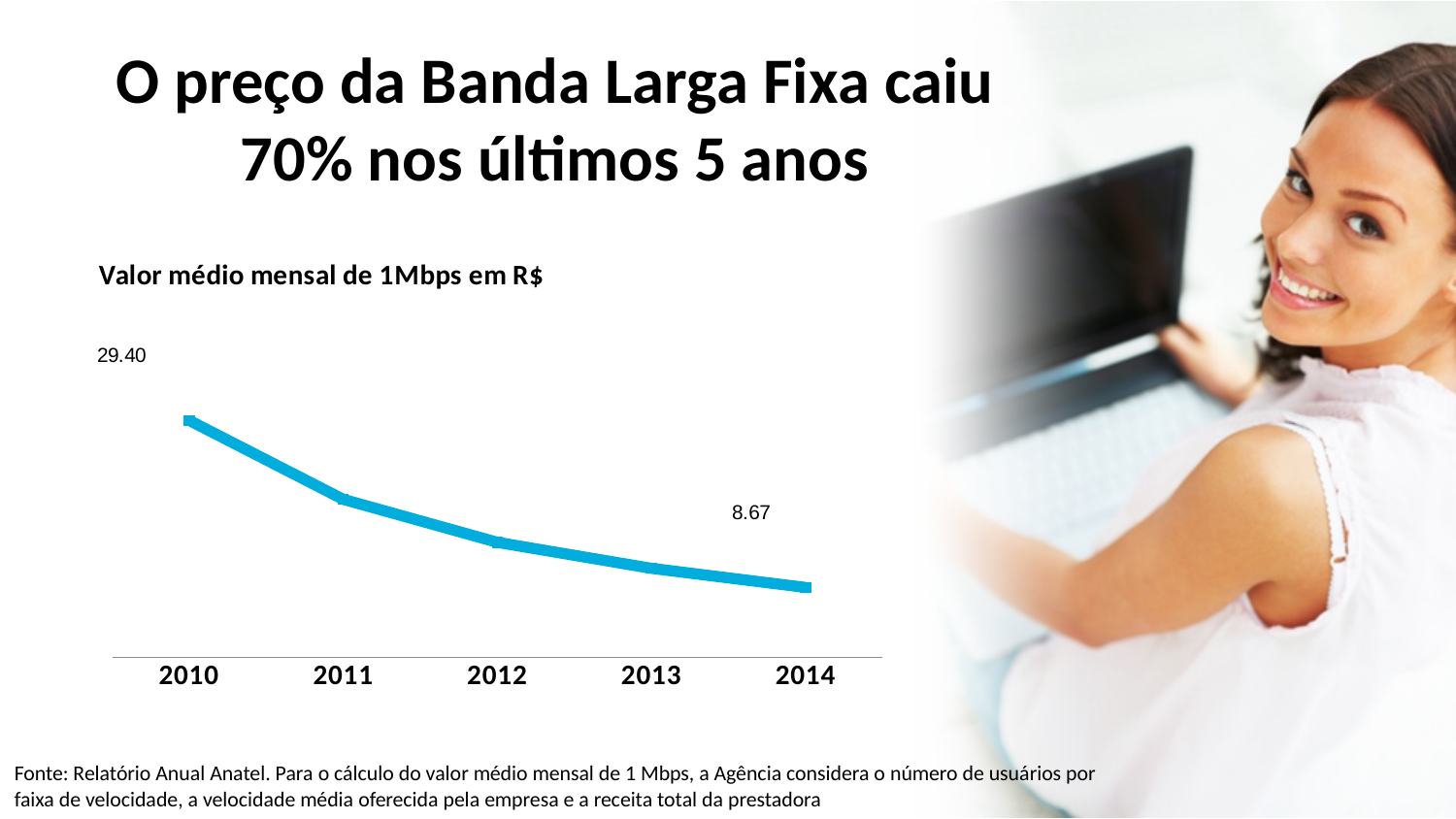
Do the values rise or fall from 2010 to 2014? fall What is the value for 2014? 8.67 Which year has the highest value? 2010 Which is larger, the value for 2011 or the value for 2013? 2011 What is the value for 2010? 29.40 What is the title of the chart? Valor médio mensal de 1Mbps em R$ What colour is the line in the chart? blue Which is larger, the value for 2010 or the value for 2014? 2010 What is the difference between the values for 2010 and 2014? 20.73 What kind of chart is shown on the slide? line chart How many years are shown on the x axis? 5 Which year has the lowest value? 2014